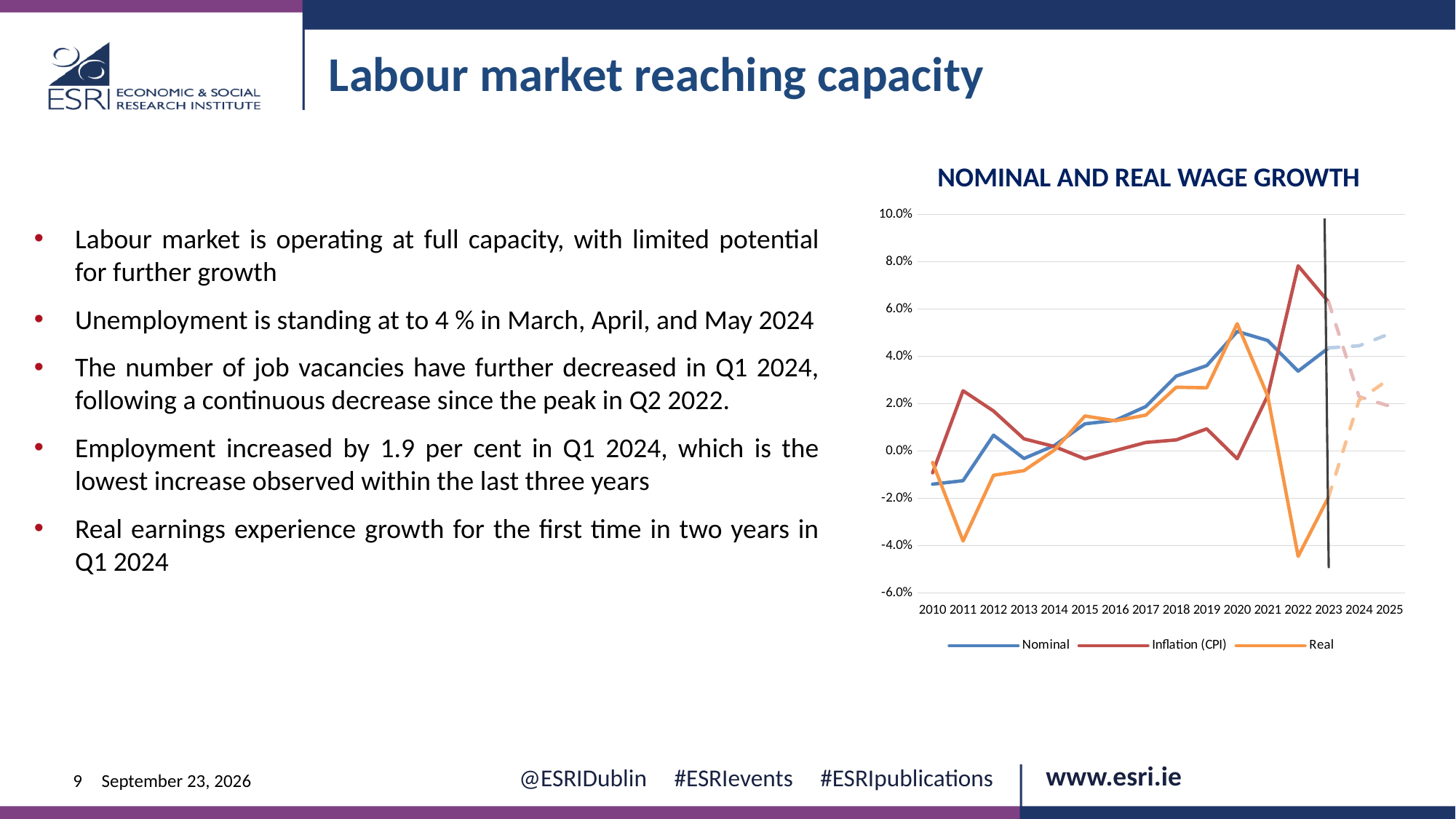
Is the value for Real in 2011 greater or less than -2.0%? less How many years are labelled on the x axis of the chart? 16 How many series does the legend of the chart list? 3 Is the value for Nominal in 2020 greater or less than 4.0%? greater In which year does the Inflation (CPI) series reach its highest value? 2022 What are the three series named in the chart legend? Nominal, Inflation (CPI), Real What kind of chart is shown on the slide? Line chart In 2022, which series is higher: Inflation (CPI) or Nominal? Inflation (CPI) What is the title of the chart? NOMINAL AND REAL WAGE GROWTH In which year does the Real series reach its lowest value? 2022 Is the value for Inflation (CPI) in 2022 greater or less than 6.0%? greater In 2011, which series is higher: Inflation (CPI) or Real? Inflation (CPI)